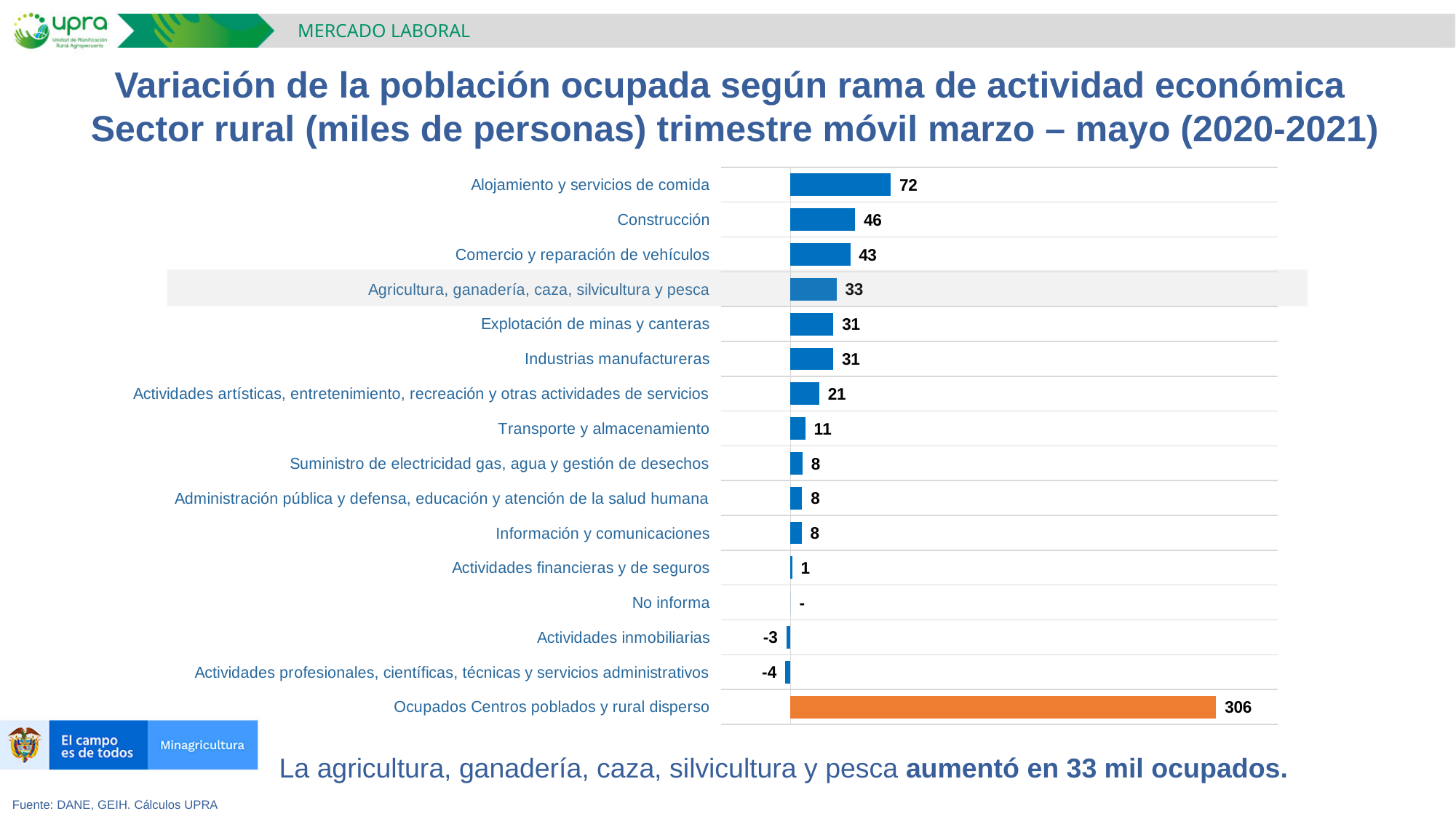
What is the value for Transporte y almacenamiento? 11 What is the value for Alojamiento y servicios de comida? 72 What kind of chart is shown on the slide? Bar chart What is the value for Agricultura, ganadería, caza, silvicultura y pesca? 33 Which is larger, the value for Comercio y reparación de vehículos or the value for Explotación de minas y canteras? Comercio y reparación de vehículos Which category has the lowest value in the chart? Actividades profesionales, científicas, técnicas y servicios administrativos What is the value for Ocupados Centros poblados y rural disperso? 306 What is the difference between the values for Alojamiento y servicios de comida and Construcción? 26 Which bar in the chart is coloured orange rather than blue? Ocupados Centros poblados y rural disperso How many categories are shown in the chart? 16 What is the value for Actividades profesionales, científicas, técnicas y servicios administrativos? -4 Which category has the highest value in the chart? Ocupados Centros poblados y rural disperso